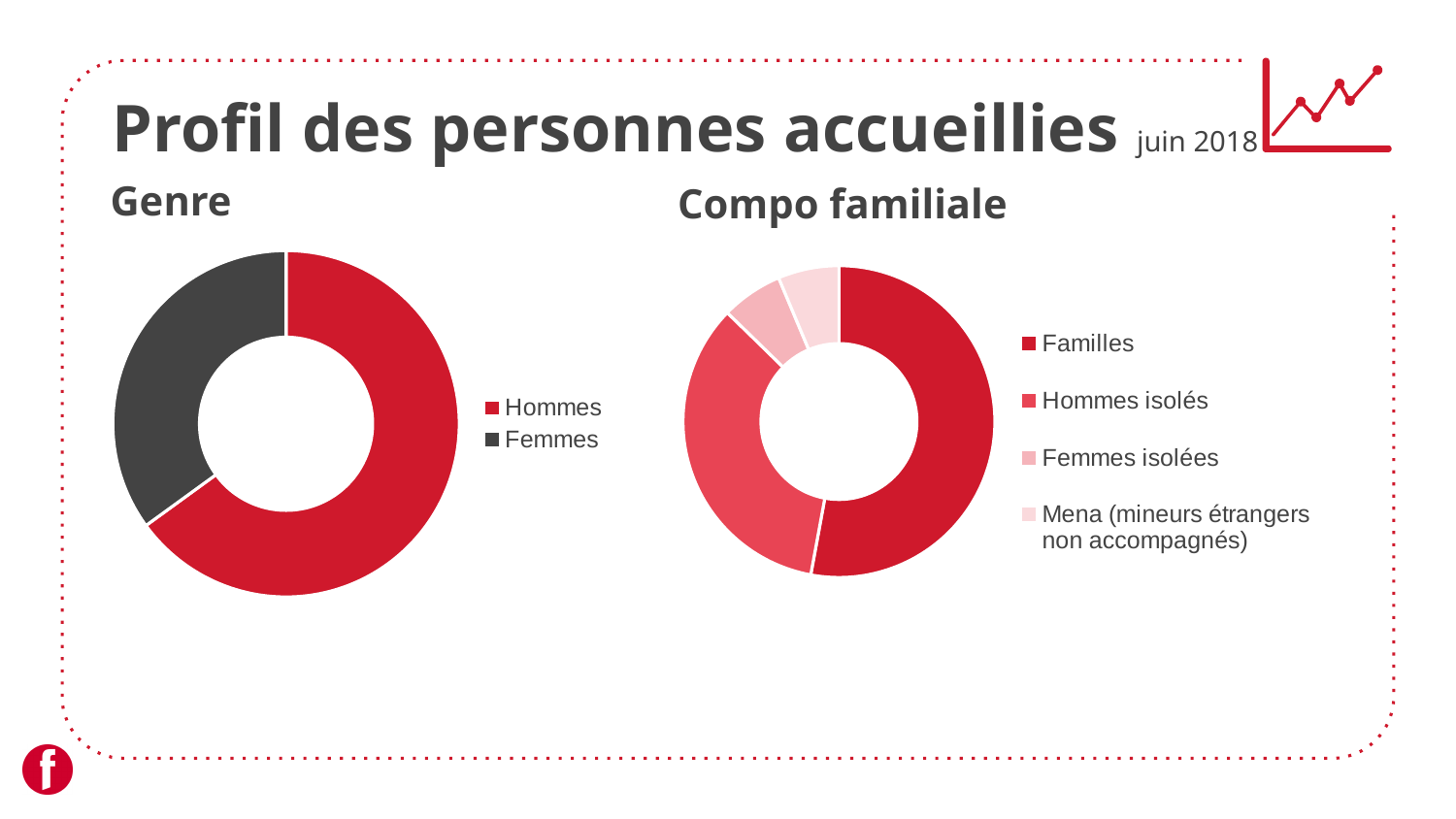
In the "Compo familiale" chart, which category has the largest share? Familles In the "Compo familiale" chart, which is larger: Familles or Hommes isolés? Familles What kind of chart is the "Genre" chart? Pie chart (donut) In the "Genre" chart, what colour represents Femmes? Dark grey In the "Genre" chart, which category has the largest share? Hommes In the "Compo familiale" chart, how many categories are shown? 4 What kind of chart is the "Compo familiale" chart? Pie chart (donut) In the "Genre" chart, which category has the smallest share? Femmes In the "Genre" chart, how many categories are shown? 2 In the "Genre" chart, which is larger: Hommes or Femmes? Hommes What is the title of the slide containing the two charts? Profil des personnes accueillies In the "Compo familiale" chart, which is larger: Hommes isolés or Femmes isolées? Hommes isolés